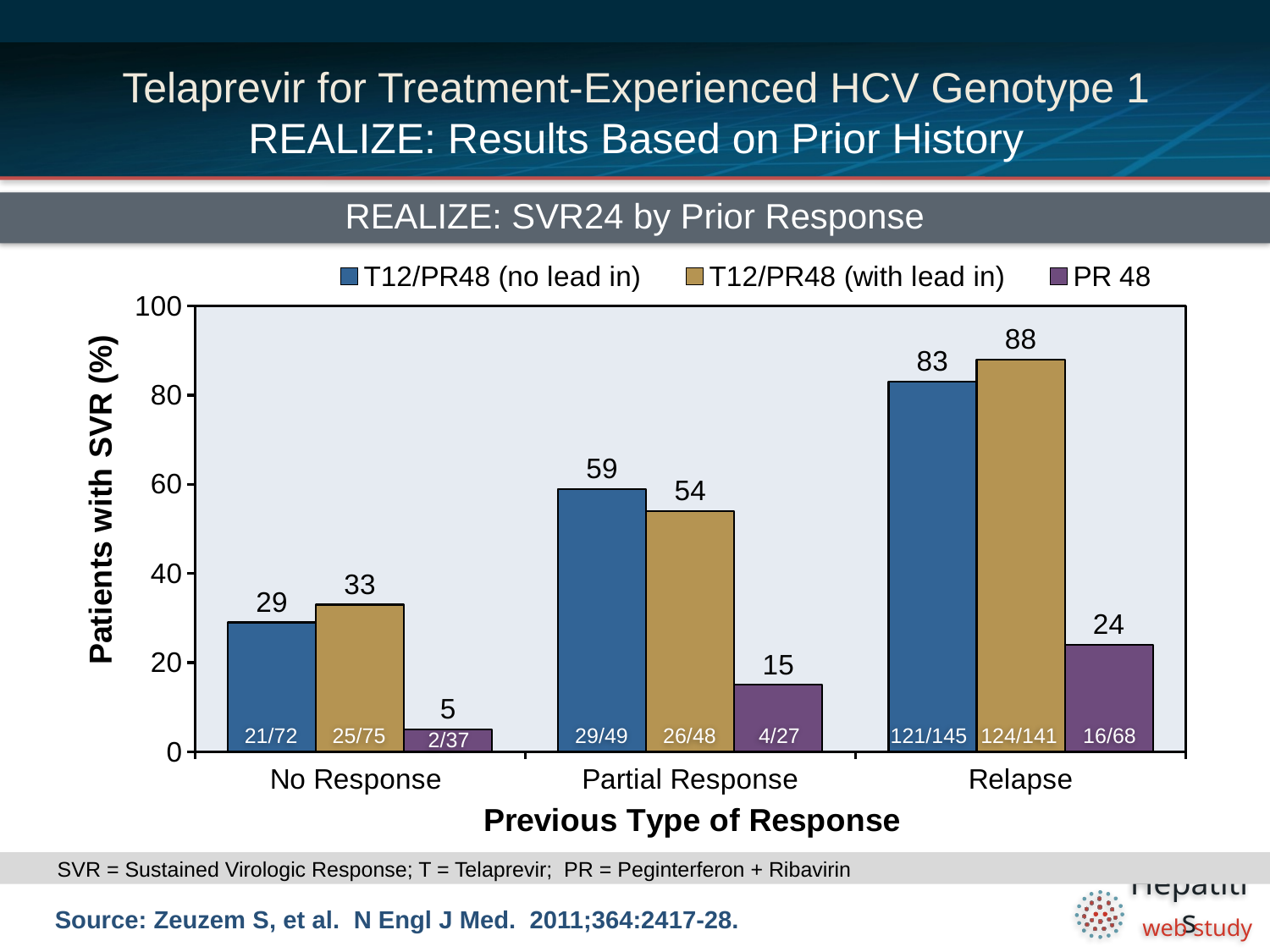
Which prior response category has the lowest SVR rate for PR 48? No Response What is the difference between the T12/PR48 (with lead in) and PR 48 SVR rates in the Relapse group? 64 How many series does the legend list? 3 What kind of chart is shown on the slide? Bar chart What is the title of the chart? REALIZE: SVR24 by Prior Response What is the SVR rate for PR 48 in the Relapse group? 24 How many prior response categories are shown on the x axis? 3 Do the SVR rates for PR 48 rise or fall from No Response to Relapse? Rise What is the SVR rate for T12/PR48 (with lead in) in the Partial Response group? 54 In the Partial Response group, which is larger: the SVR rate for T12/PR48 (no lead in) or T12/PR48 (with lead in)? T12/PR48 (no lead in) What is the SVR rate for T12/PR48 (no lead in) in the No Response group? 29 Which prior response category has the highest SVR rate for T12/PR48 (with lead in)? Relapse